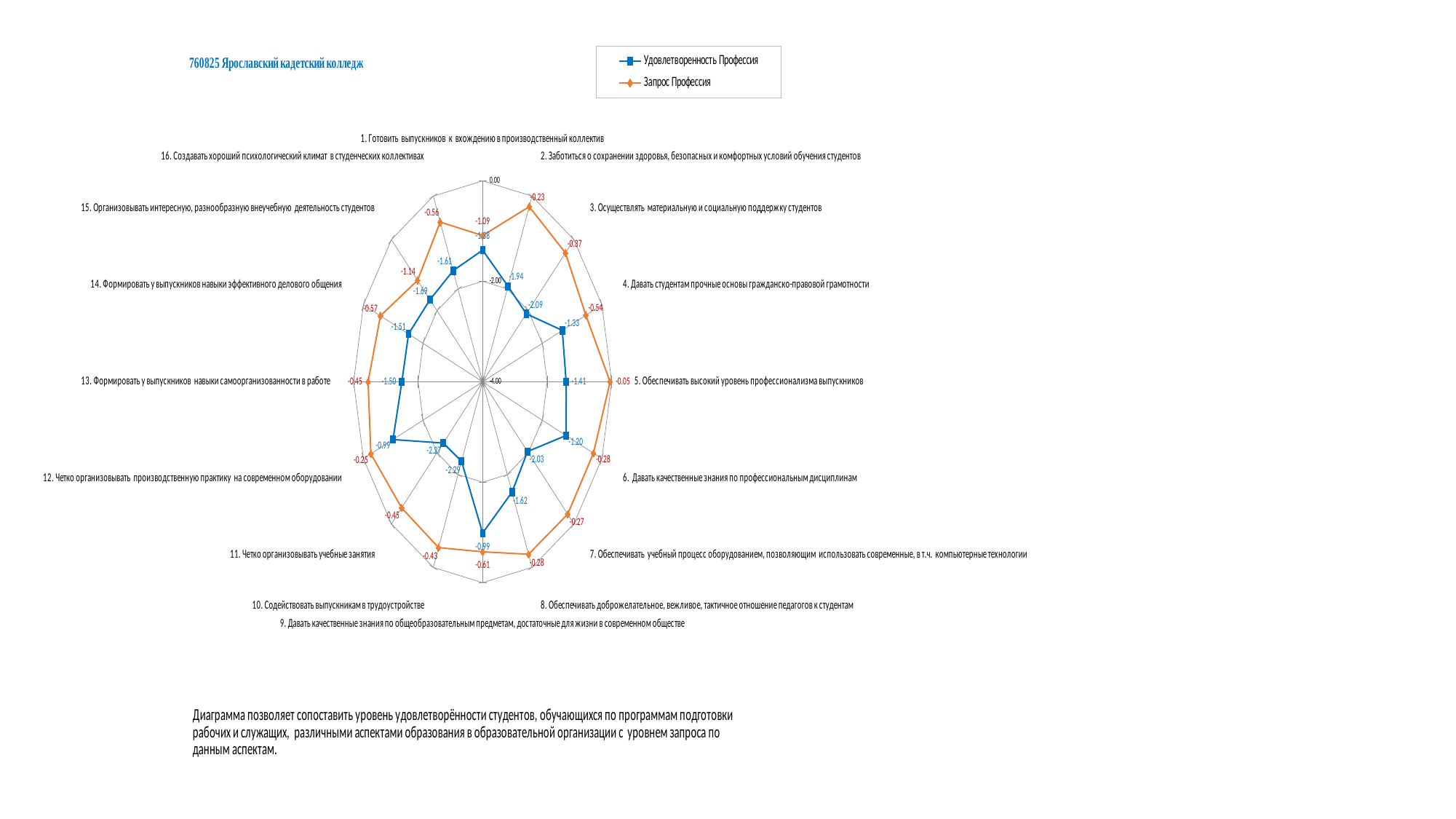
For which category is the 'Удовлетворенность Профессия' value the lowest? 10. Содействовать выпускникам в трудоустройстве What is the value of 'Запрос Профессия' for category 5 (Обеспечивать высокий уровень профессионализма выпускников)? -0.05 How many series does the legend list? 2 How many categories (axes) does the radar chart have? 16 What is the value of 'Удовлетворенность Профессия' for category 7 (Обеспечивать учебный процесс оборудованием...)? -2.03 What kind of chart is shown on the slide? Radar chart What is the value of 'Удовлетворенность Профессия' for category 3 (Осуществлять материальную и социальную поддержку студентов)? -2.09 What is the title shown above the chart? 760825 Ярославский кадетский колледж For which category is the 'Запрос Профессия' value the lowest? 15. Организовывать интересную, разнообразную внеучебную деятельность студентов For category 5, which series has the higher value: 'Удовлетворенность Профессия' or 'Запрос Профессия'? Запрос Профессия What is the difference between 'Запрос Профессия' (-0.05) and 'Удовлетворенность Профессия' (-1.41) for category 5? 1.36 What is the value of 'Запрос Профессия' for category 15 (Организовывать интересную, разнообразную внеучебную деятельность студентов)? -1.14